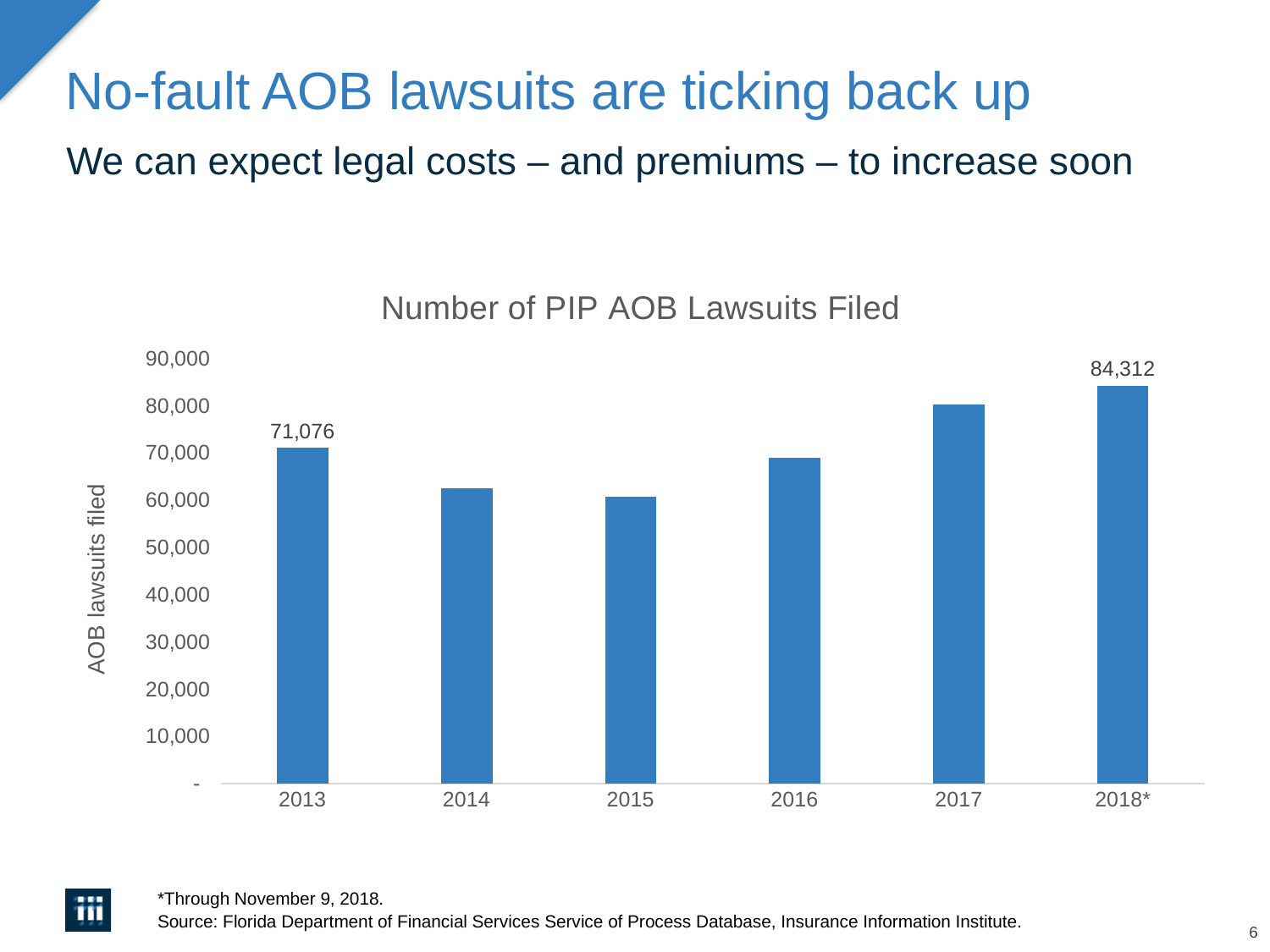
Is the value for 2015 greater or less than 70,000? less How many years are shown on the x axis of the chart? 6 Is the value for 2017 greater or less than 70,000? greater Is the value for 2016 greater or less than 60,000? greater What is the title of the chart? Number of PIP AOB Lawsuits Filed What is the number of PIP AOB lawsuits filed in 2018*? 84,312 What is the number of PIP AOB lawsuits filed in 2013? 71,076 What is the difference between the number of lawsuits filed in 2018* and in 2013? 13,236 Which year has the lowest number of PIP AOB lawsuits filed? 2015 Which year had more PIP AOB lawsuits filed, 2014 or 2017? 2017 What kind of chart is shown on the slide? Bar chart Which year has the highest number of PIP AOB lawsuits filed? 2018*